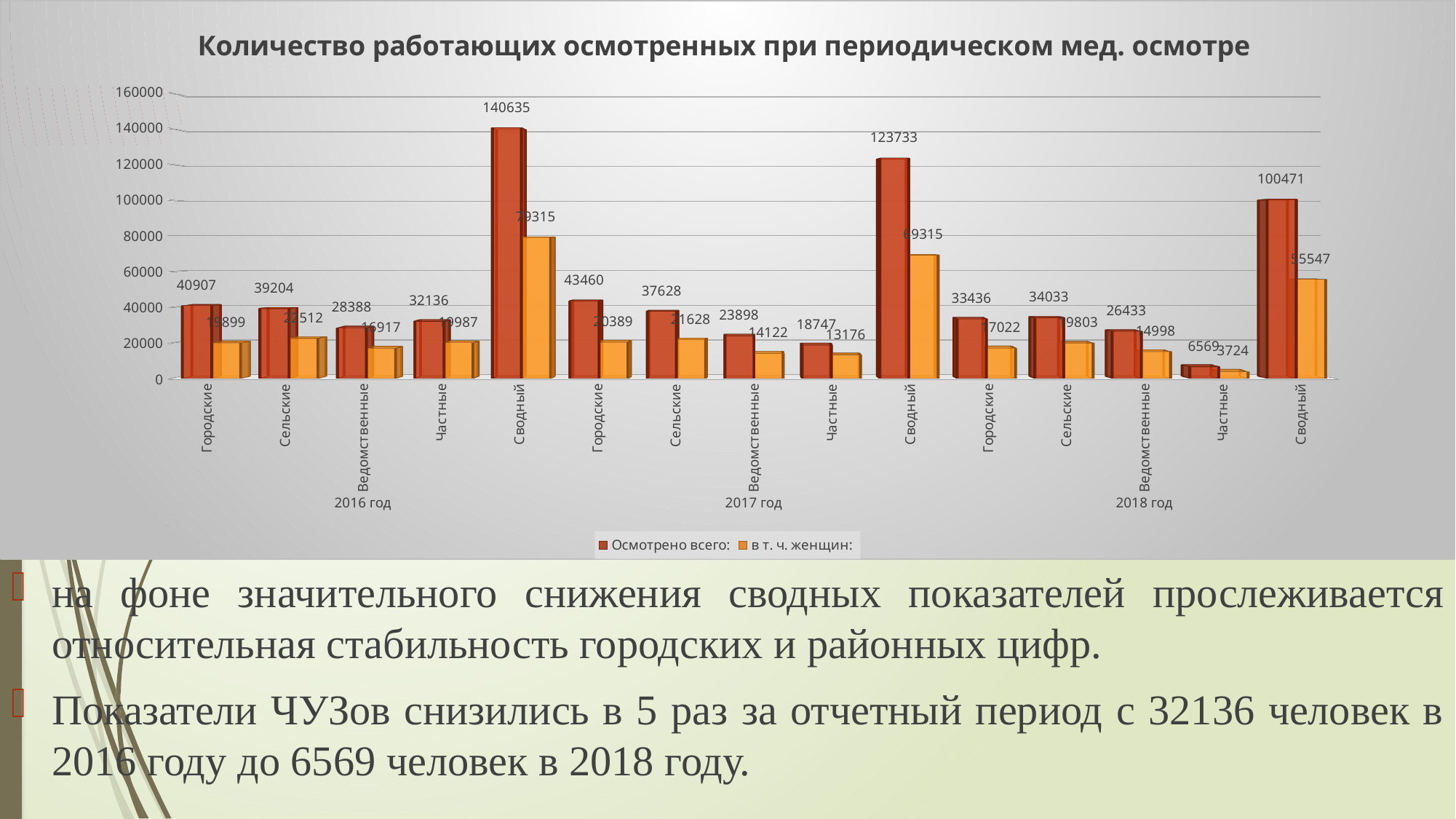
What kind of chart is shown on the slide? bar chart What is the value of "Осмотрено всего:" for Сводный in 2016 год? 140635 Does the "Осмотрено всего:" value for Сводный rise or fall from 2016 год to 2018 год? fall What is the value of "Осмотрено всего:" for Частные in 2018 год? 6569 What is the difference between the "Осмотрено всего:" values for Сводный in 2016 год and Сводный in 2018 год? 40164 What is the difference between the "Осмотрено всего:" values for Частные in 2016 год and Частные in 2018 год? 25567 How many series does the legend list? 2 What is the value of "в т. ч. женщин:" for Сводный in 2017 год? 69315 Which category has the lowest "Осмотрено всего:" value on the chart? Частные, 2018 год Which category has the highest "Осмотрено всего:" value on the chart? Сводный, 2016 год What is the value of "в т. ч. женщин:" for Частные in 2018 год? 3724 Which is larger: "Осмотрено всего:" for Городские in 2016 год or for Городские in 2017 год? Городские in 2017 год